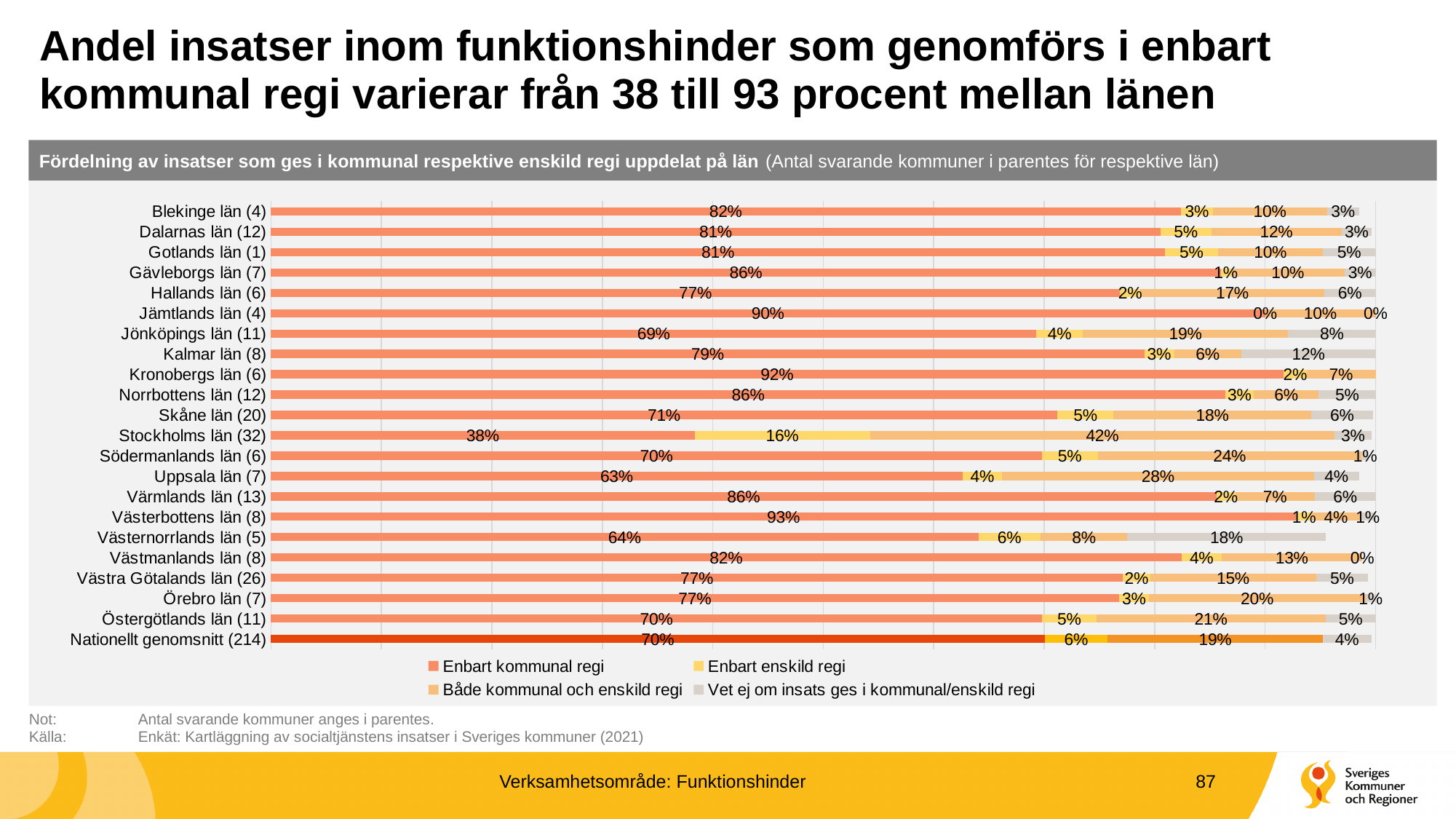
Which category has the lowest value for "Enbart kommunal regi"? Stockholms län (32) How many series does the legend list? 4 Which legend entry is shown in yellow? Enbart enskild regi What is the difference between the "Enbart kommunal regi" values for Västerbottens län (8) and Stockholms län (32)? 55% Which category has the highest value for "Enbart kommunal regi"? Västerbottens län (8) How many categories are shown on the y axis of the chart? 22 What is the value of "Enbart enskild regi" for Nationellt genomsnitt (214)? 6% What is the value of "Både kommunal och enskild regi" for Uppsala län (7)? 28% What is the value of "Vet ej om insats ges i kommunal/enskild regi" for Västernorrlands län (5)? 18% What is the value of "Enbart kommunal regi" for Stockholms län (32)? 38% What kind of chart is shown on the slide? Stacked bar chart Which has a larger "Både kommunal och enskild regi" value, Stockholms län (32) or Södermanlands län (6)? Stockholms län (32)